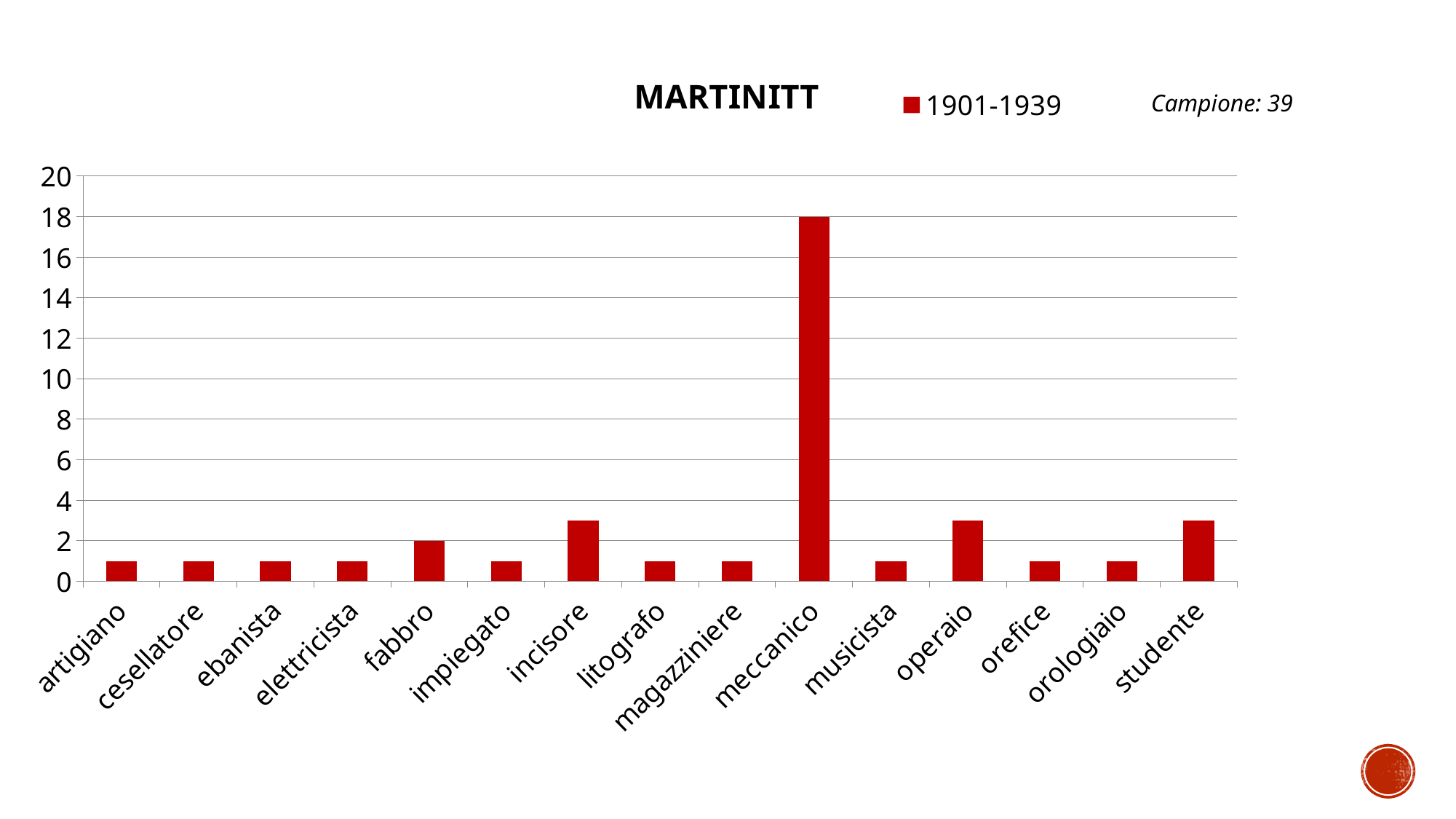
What series does the legend list? 1901-1939 Which is larger, the value for operaio or the value for orefice? operaio Is the value for artigiano greater or less than 2? less How many series does the legend list? 1 What is the title of the chart? MARTINITT What is the value for fabbro? 2 What is the difference between the values for meccanico and fabbro? 16 What is the value for meccanico? 18 Which category has the highest value? meccanico Is the value for incisore greater or less than 2? greater What type of chart is shown on the slide? bar chart How many categories are shown on the x axis? 15